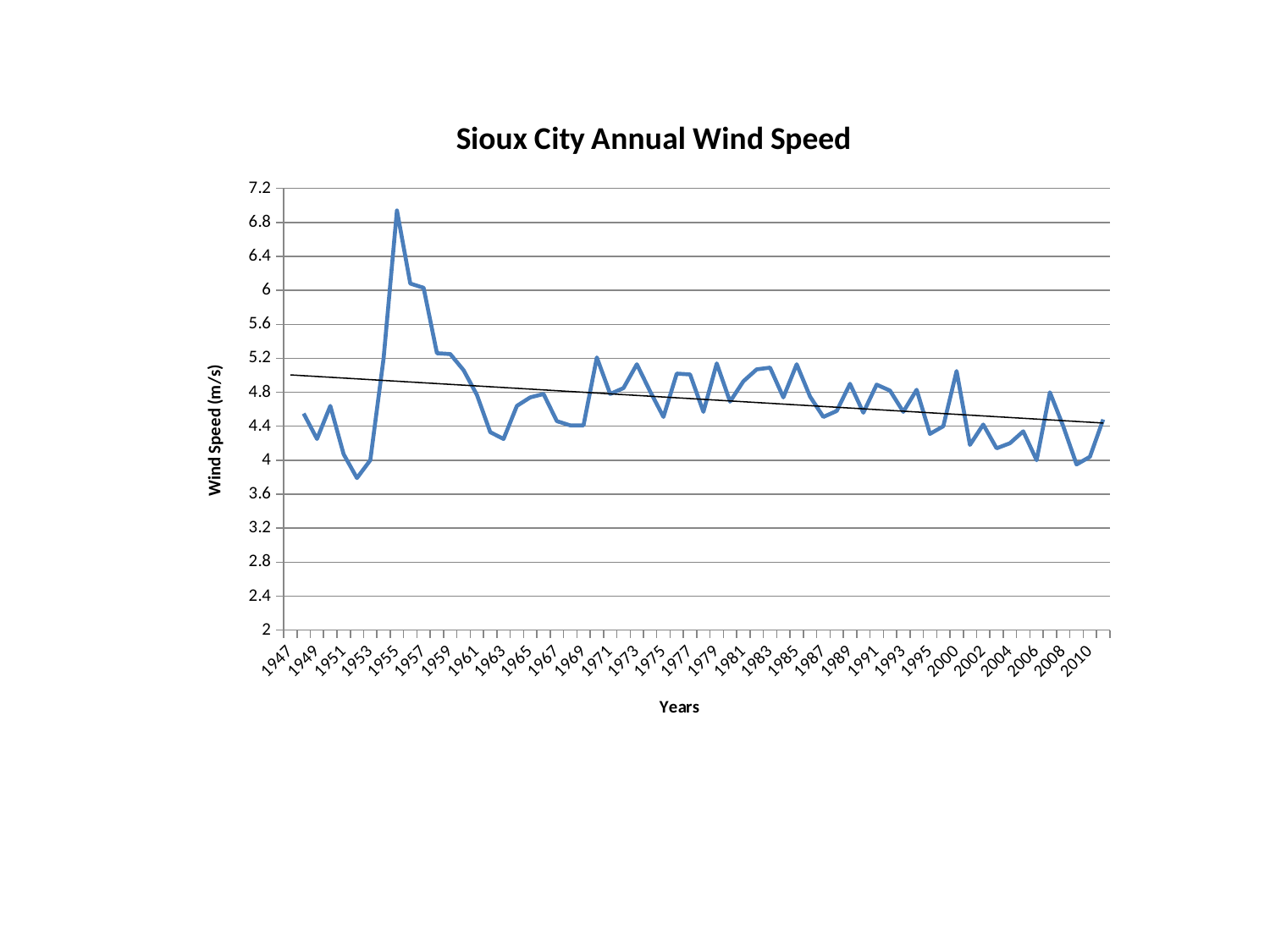
According to the trend line, does the wind speed generally rise or fall from 1947 to 2010? fall Is the wind speed for 1985 greater or less than 4.8? greater Which year has the higher wind speed, 1955 or 2006? 1955 Is the wind speed for 1955 greater or less than 6.4? greater What is the title of the chart? Sioux City Annual Wind Speed In which year does the wind speed reach its highest value? 1955 Is the wind speed for 2006 greater or less than 4.4? less Which year has the higher wind speed, 1985 or 2010? 1985 What kind of chart is shown on the slide? line chart What is the label of the vertical axis? Wind Speed (m/s)